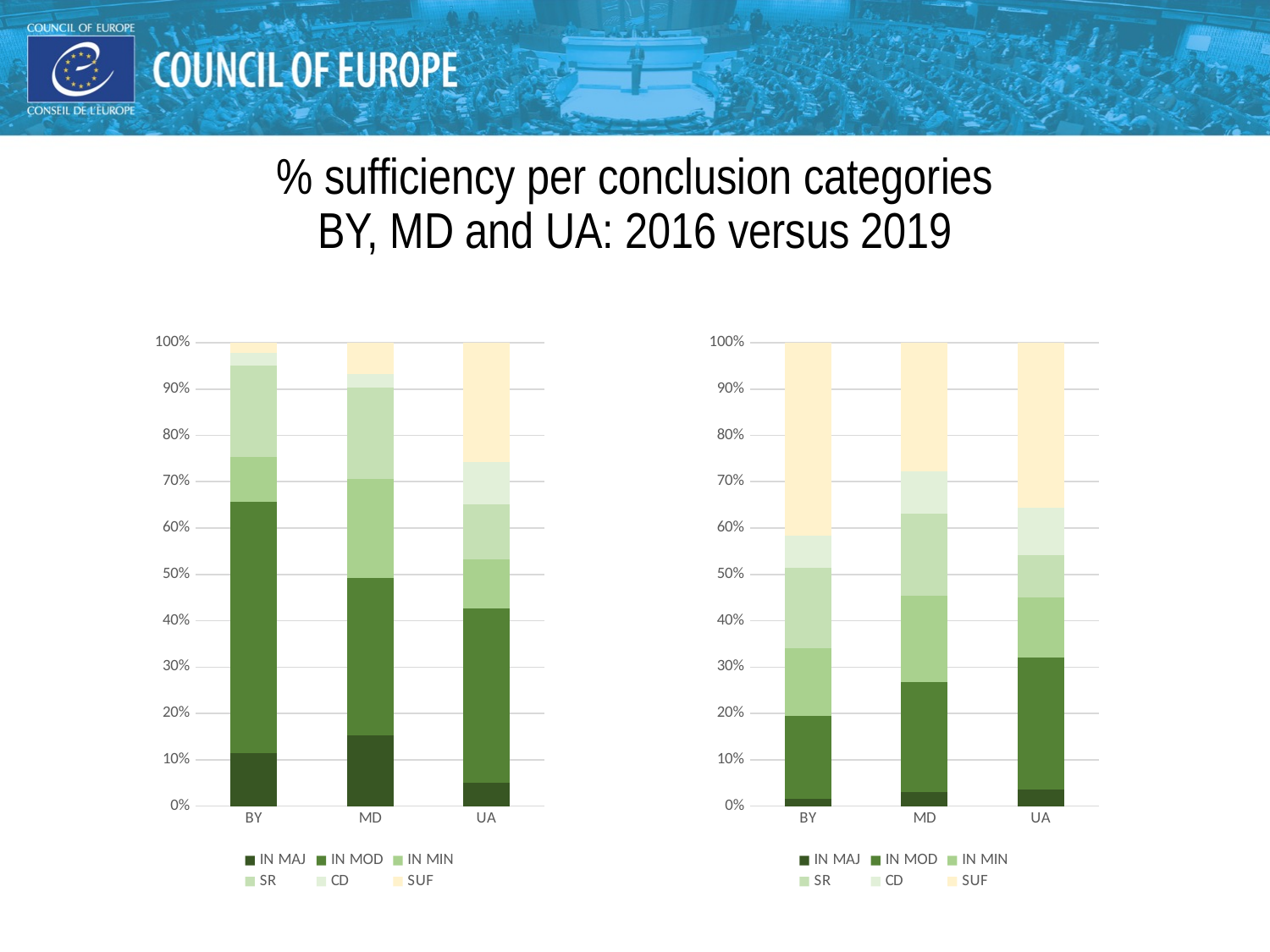
What kind of chart is the left chart on the slide? Stacked bar chart In the right chart, which category has the highest SUF value? BY How many series does the legend of the left chart list? 6 In the right chart, is the IN MOD value for MD greater or less than 20%? greater How many categories are shown on the x axis of the right chart? 3 In the left chart, which category has the lowest SUF value? BY In the left chart, which category has the larger SUF value, BY or UA? UA In the left chart, is the IN MAJ value for UA greater or less than 10%? less In the left chart, is the IN MAJ value for MD greater or less than 10%? greater What are the six legend entries of the right chart? IN MAJ, IN MOD, IN MIN, SR, CD, SUF In the left chart, which category has the larger IN MAJ value, BY or MD? MD